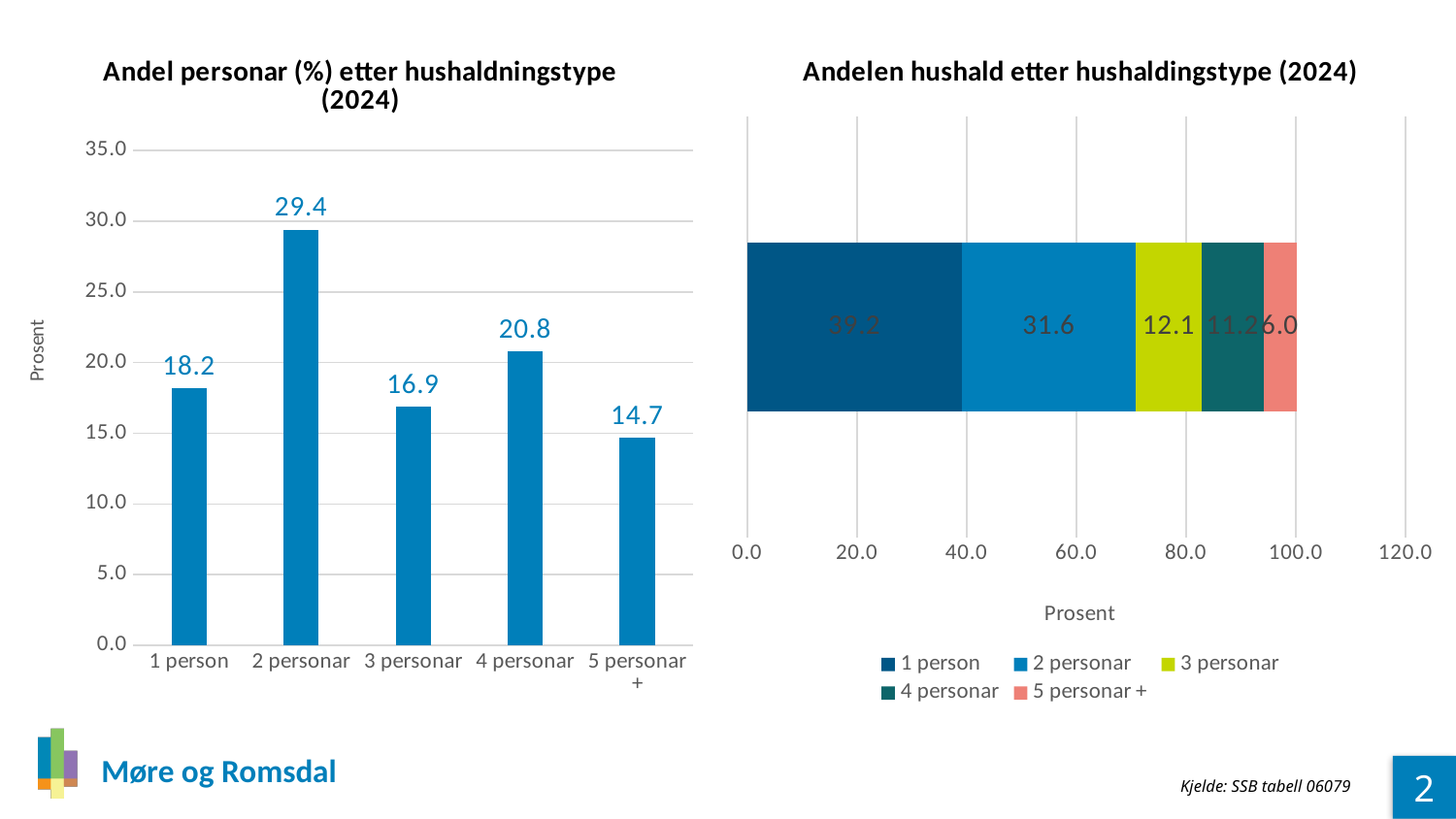
How many series does the legend of the chart 'Andelen hushald etter hushaldingstype (2024)' list? 5 In the chart 'Andel personar (%) etter hushaldningstype (2024)', what is the difference between the values for 4 personar and 3 personar? 3.9 In the chart 'Andel personar (%) etter hushaldningstype (2024)', what is the value for 5 personar +? 14.7 In the chart 'Andelen hushald etter hushaldingstype (2024)', which is larger, the value for 2 personar or the value for 4 personar? 2 personar What kind of chart is 'Andel personar (%) etter hushaldningstype (2024)'? Bar chart In the chart 'Andelen hushald etter hushaldingstype (2024)', what is the total of the stacked bar? 100.1 In the chart 'Andel personar (%) etter hushaldningstype (2024)', which household type has the highest value? 2 personar In the chart 'Andel personar (%) etter hushaldningstype (2024)', what is the value for 2 personar? 29.4 In the chart 'Andelen hushald etter hushaldingstype (2024)', what is the value for 1 person? 39.2 In the chart 'Andel personar (%) etter hushaldningstype (2024)', which household type has the lowest value? 5 personar + In the chart 'Andel personar (%) etter hushaldningstype (2024)', how many household types are shown on the x axis? 5 In the chart 'Andelen hushald etter hushaldingstype (2024)', what is the value for 3 personar? 12.1